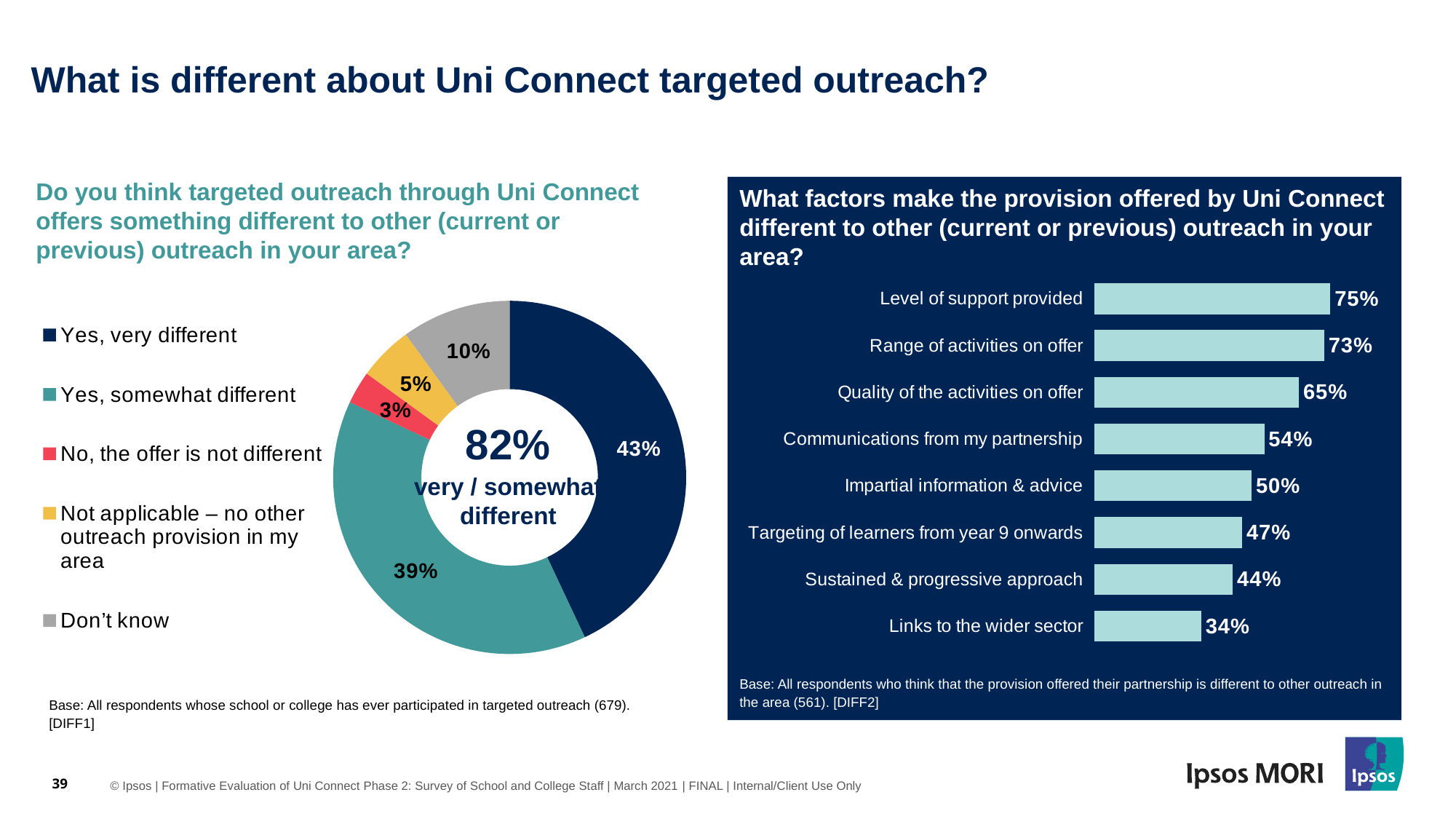
In the bar chart on the right, which is larger: 'Communications from my partnership' or 'Impartial information & advice'? Communications from my partnership In the doughnut chart on the left, what percentage of respondents said 'Yes, very different'? 43% In the doughnut chart on the left, which response has the smallest share? No, the offer is not different In the bar chart on the right, which factor has the highest value? Level of support provided In the bar chart on the right, what is the value for 'Quality of the activities on offer'? 65% In the bar chart on the right, how many factors are listed? 8 In the bar chart on the right, what is the difference between 'Level of support provided' and 'Links to the wider sector'? 41 percentage points In the bar chart on the right, which factor has the lowest value? Links to the wider sector In the doughnut chart on the left, how many categories does the legend list? 5 In the doughnut chart on the left, what is the combined share of 'Yes, very different' and 'Yes, somewhat different'? 82% In the doughnut chart on the left, what percentage of respondents said 'Don't know'? 10% What type of chart is shown on the left side of the slide? Doughnut chart